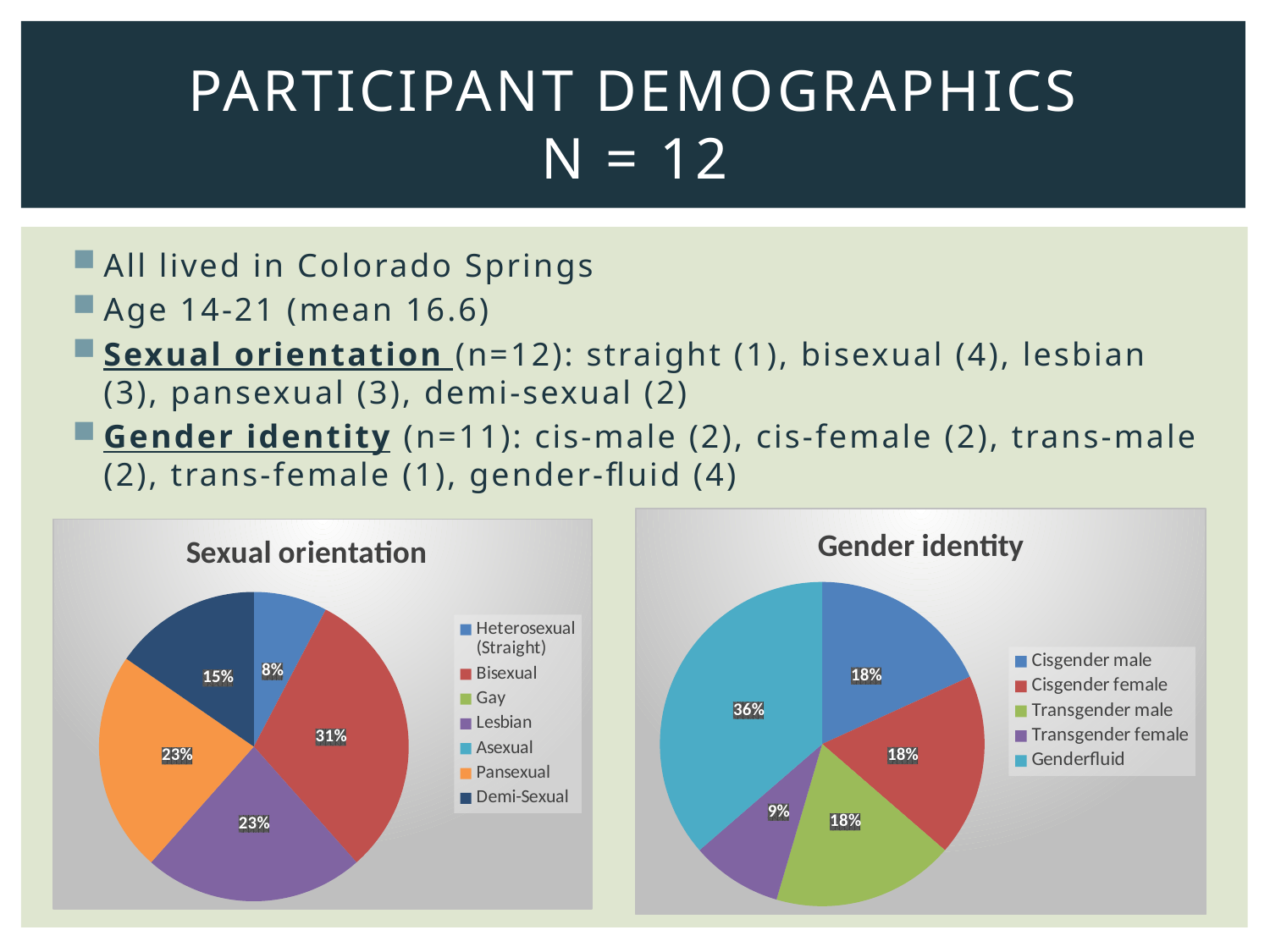
In the Sexual orientation chart, which category has the largest slice? Bisexual In the Sexual orientation chart, what is the difference between the Bisexual and Demi-Sexual shares? 16% In the Gender identity chart, which category has the largest slice? Genderfluid In the Gender identity chart, which is larger, Genderfluid or Cisgender male? Genderfluid In the Sexual orientation chart, how many entries does the legend list? 7 In the Gender identity chart, what share of the pie is Transgender female? 9% In the Sexual orientation chart, what share of the pie is Heterosexual (Straight)? 8% In the Sexual orientation chart, what share of the pie is Bisexual? 31% In the Gender identity chart, what share of the pie is Genderfluid? 36% In the Sexual orientation chart, which category has the smallest visible slice? Heterosexual (Straight) In the Gender identity chart, how many categories does the legend list? 5 What type of chart is the Gender identity chart? Pie chart